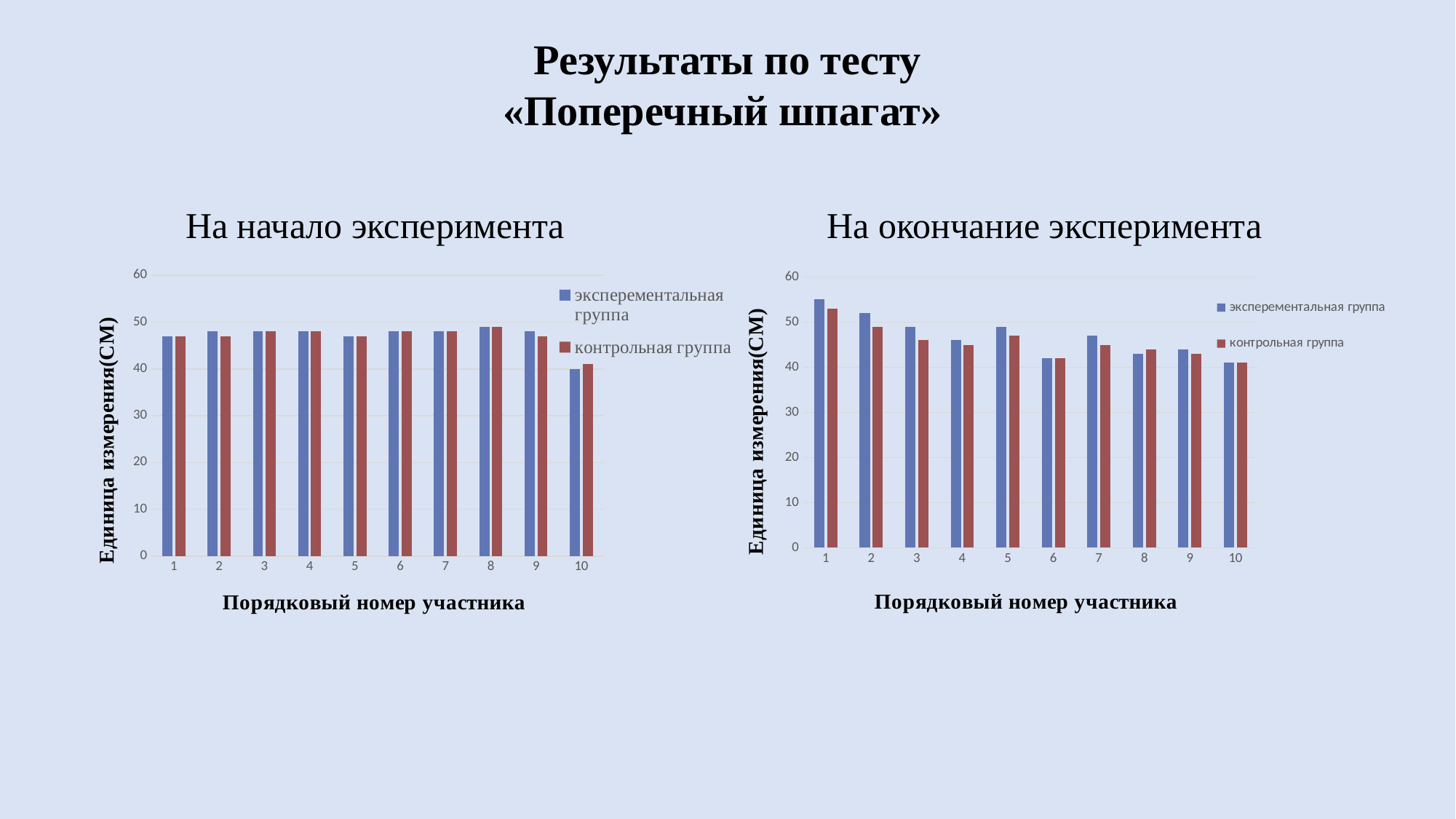
In the right chart «На окончание эксперимента», how many series does the legend list? 2 In the left chart «На начало эксперимента», is the value for participant 10 in the экспериментальная группа series greater or less than 50? less In the right chart «На окончание эксперимента», which participant has the highest value in the экспериментальная группа series? 1 What is the y-axis title of the left chart «На начало эксперимента»? Единица измерения(СМ) In the right chart «На окончание эксперимента», which colour represents the контрольная группа series? red In the left chart «На начало эксперимента», which participant has the lowest value in the экспериментальная группа series? 10 What kind of chart is the left chart titled «На начало эксперимента»? bar chart In the right chart «На окончание эксперимента», is the value for participant 1 in the экспериментальная группа series greater or less than 50? greater In the right chart «На окончание эксперимента», is the value for participant 6 in the экспериментальная группа series greater or less than 50? less In the left chart «На начало эксперимента», how many participants are shown on the x axis? 10 In the right chart «На окончание эксперимента», which is larger in the экспериментальная группа series: participant 1 or participant 10? participant 1 In the right chart «На окончание эксперимента», for participant 2, which series has the larger value: экспериментальная группа or контрольная группа? экспериментальная группа